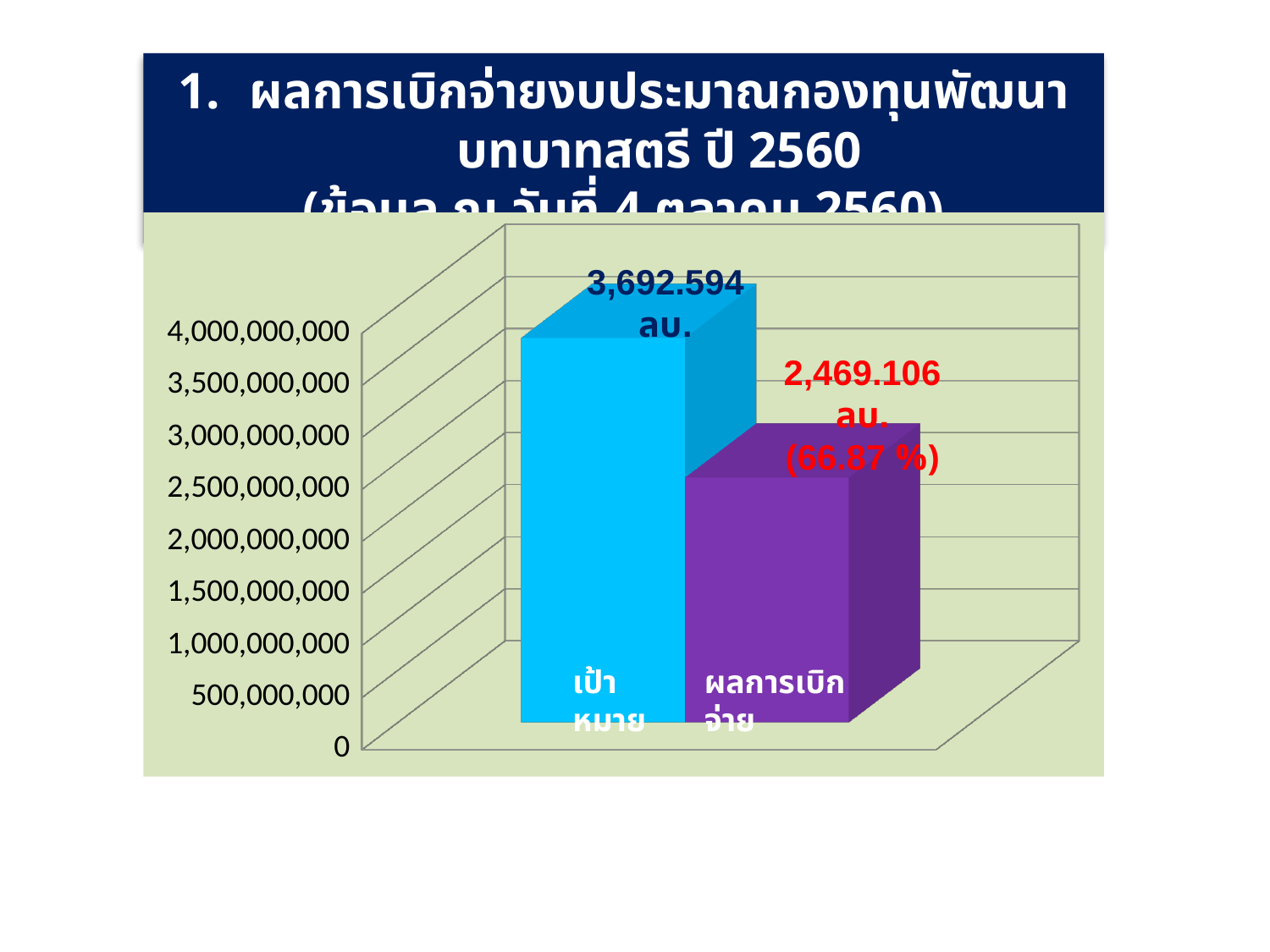
What percentage is shown next to the ผลการเบิกจ่าย bar? 66.87 % What is the value shown for เป้าหมาย? 3,692.594 ลบ. Which category has the higher value? เป้าหมาย Is the value for ผลการเบิกจ่าย greater or less than 3,000,000,000? less Is the value for เป้าหมาย greater or less than 3,500,000,000? greater What is the difference between the เป้าหมาย value and the ผลการเบิกจ่าย value? 1,223.488 ลบ. Which category has the lower value? ผลการเบิกจ่าย Is the value for เป้าหมาย larger or smaller than the value for ผลการเบิกจ่าย? larger What kind of chart is shown on the slide? bar chart How many bars are plotted in the chart? 2 What is the value shown for ผลการเบิกจ่าย? 2,469.106 ลบ. What colour is the ผลการเบิกจ่าย bar? purple